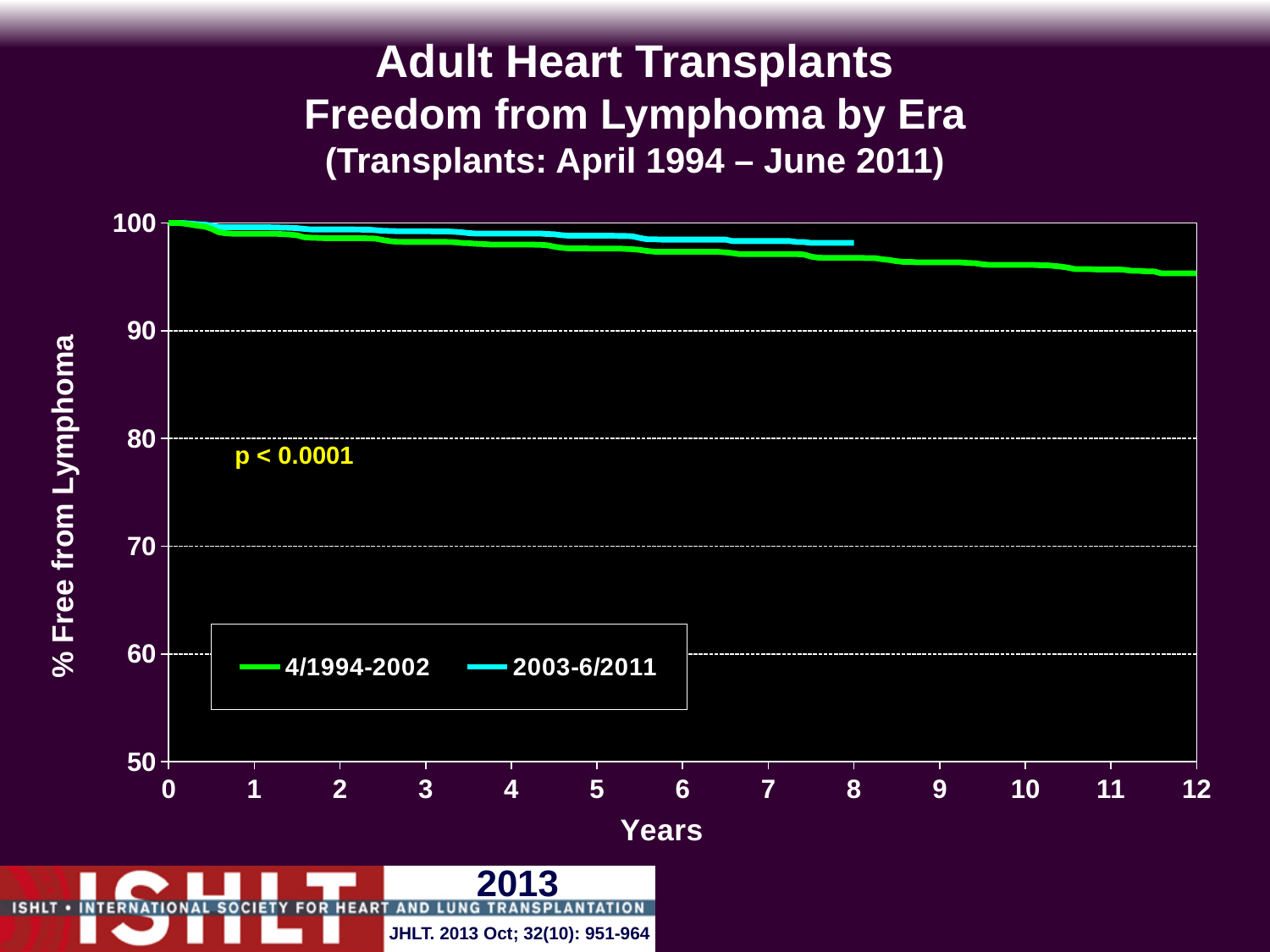
Do the values for the 2003-6/2011 series rise or fall as years increase? fall What is the label of the y axis? % Free from Lymphoma Is the value for the 2003-6/2011 series at 8 years greater or less than 90? greater Is the value for the 4/1994-2002 series at 6 years greater or less than 80? greater What is the lowest value shown on the y axis? 50 At 5 years, which series has the higher % free from lymphoma, 4/1994-2002 or 2003-6/2011? 2003-6/2011 Do the values for the 4/1994-2002 series rise or fall as years increase? fall Which two eras are listed in the legend? 4/1994-2002 and 2003-6/2011 Which series extends further along the x axis, 4/1994-2002 or 2003-6/2011? 4/1994-2002 Is the value for the 4/1994-2002 series at 12 years greater or less than 90? greater What kind of chart is shown on the slide? line chart How many series does the legend list? 2